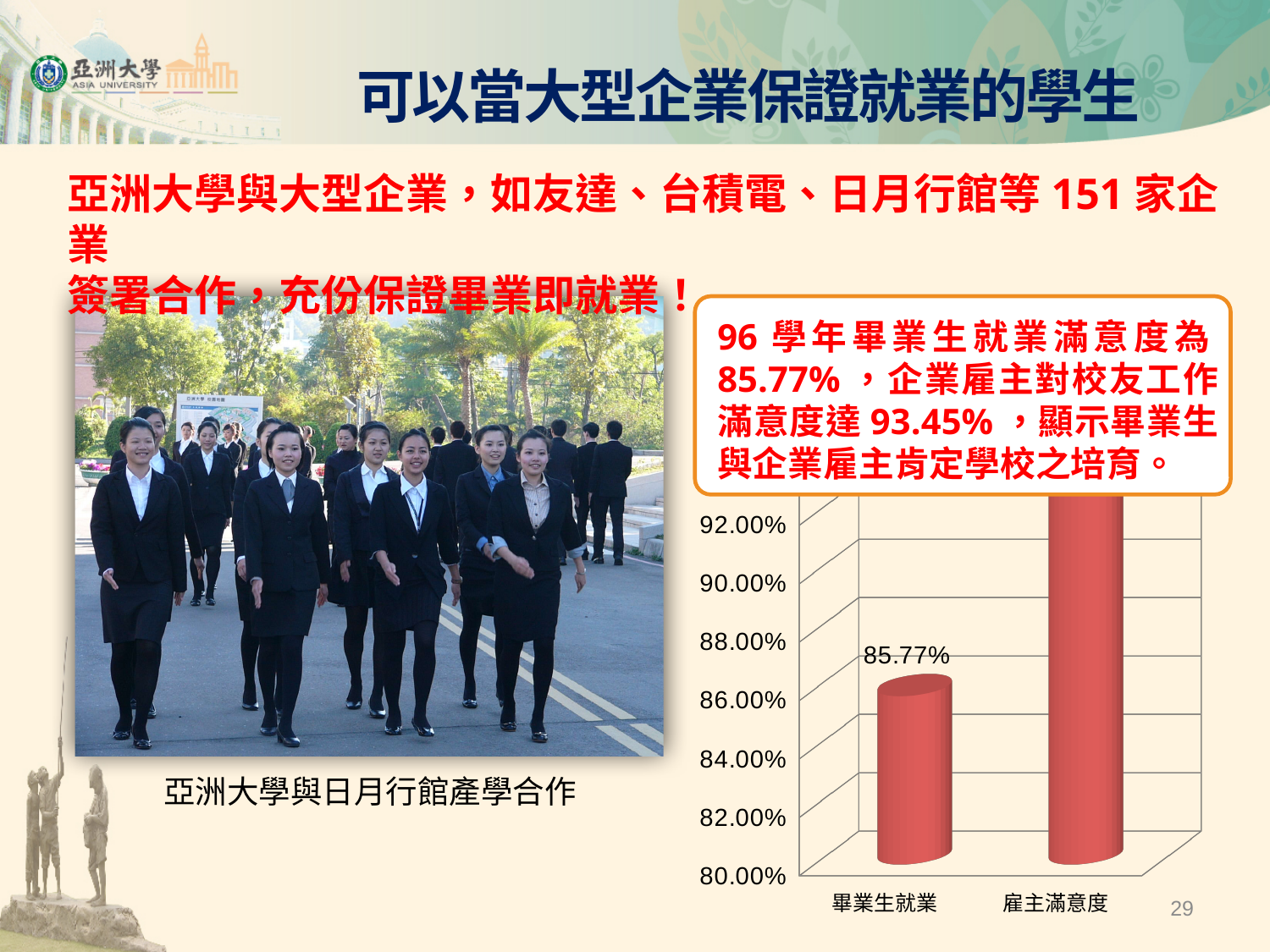
What is the value shown for 畢業生就業 in the bar chart? 85.77% Is the value for 畢業生就業 greater or less than 84.00%? greater Which category has the highest bar in the chart? 雇主滿意度 Is the value for 畢業生就業 greater or less than 88.00%? less How many categories are plotted in the bar chart? 2 Which category has the lowest bar in the chart? 畢業生就業 What colour are the bars in the chart? red What kind of chart is shown on the slide? bar chart What is the lowest value shown on the chart's vertical axis? 80.00% Is the value for 雇主滿意度 greater or less than 92.00%? greater Which is larger in the chart, 畢業生就業 or 雇主滿意度? 雇主滿意度